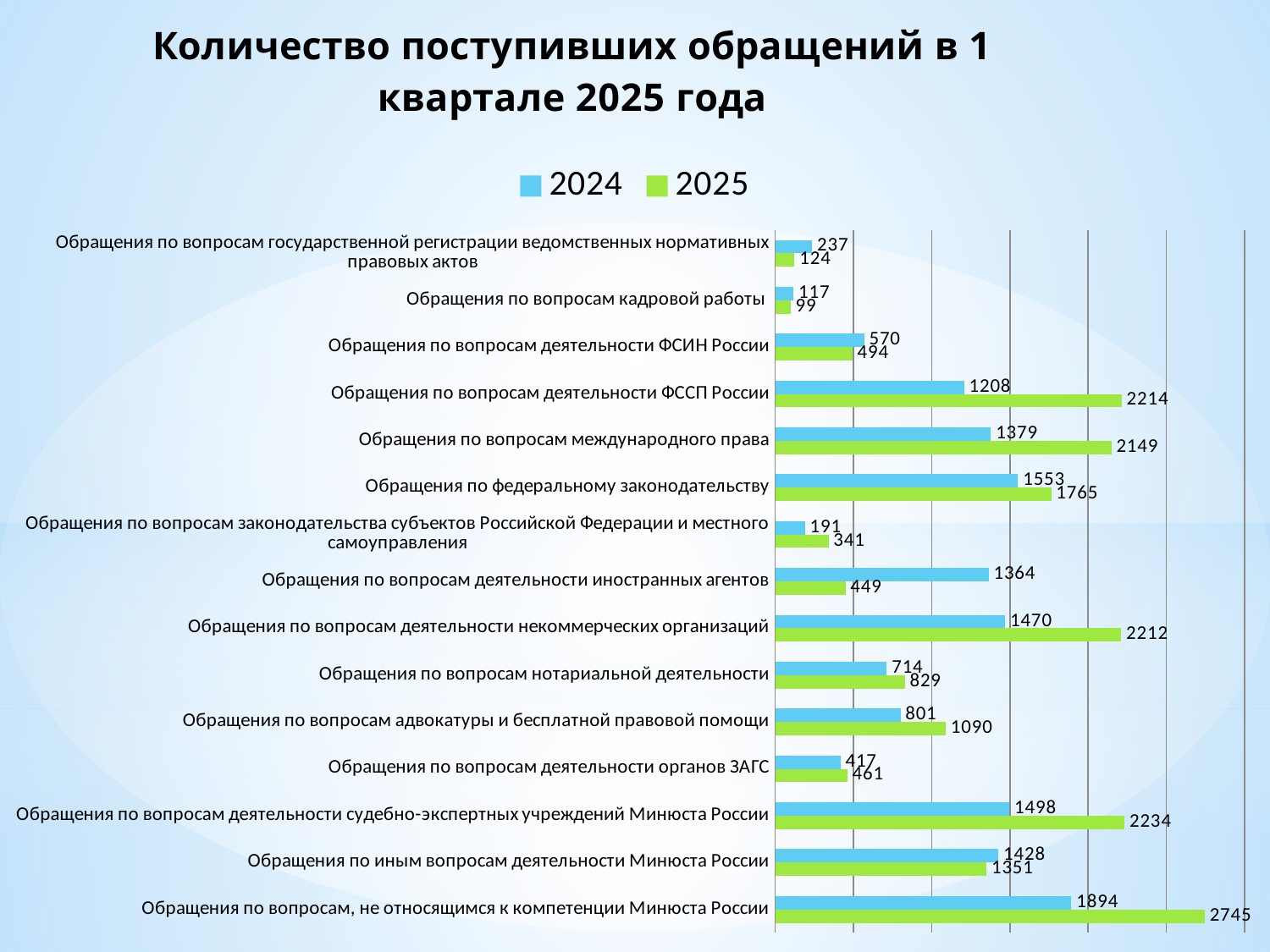
Which category has the highest 2025 value? Обращения по вопросам, не относящимся к компетенции Минюста России Which series is shown in green in the legend? 2025 What type of chart is shown on the slide? Bar chart What is the 2025 value for "Обращения по вопросам кадровой работы"? 99 What is the 2025 value for "Обращения по вопросам деятельности ФССП России"? 2214 What is the 2024 value for "Обращения по вопросам деятельности иностранных агентов"? 1364 How many categories are shown in the chart? 15 What is the difference between the 2025 and 2024 values for "Обращения по вопросам, не относящимся к компетенции Минюста России"? 851 For "Обращения по иным вопросам деятельности Минюста России", which year has the larger value, 2024 or 2025? 2024 What is the difference between the 2024 and 2025 values for "Обращения по вопросам деятельности иностранных агентов"? 915 Which category has the lowest 2024 value? Обращения по вопросам кадровой работы How many series does the legend list? 2